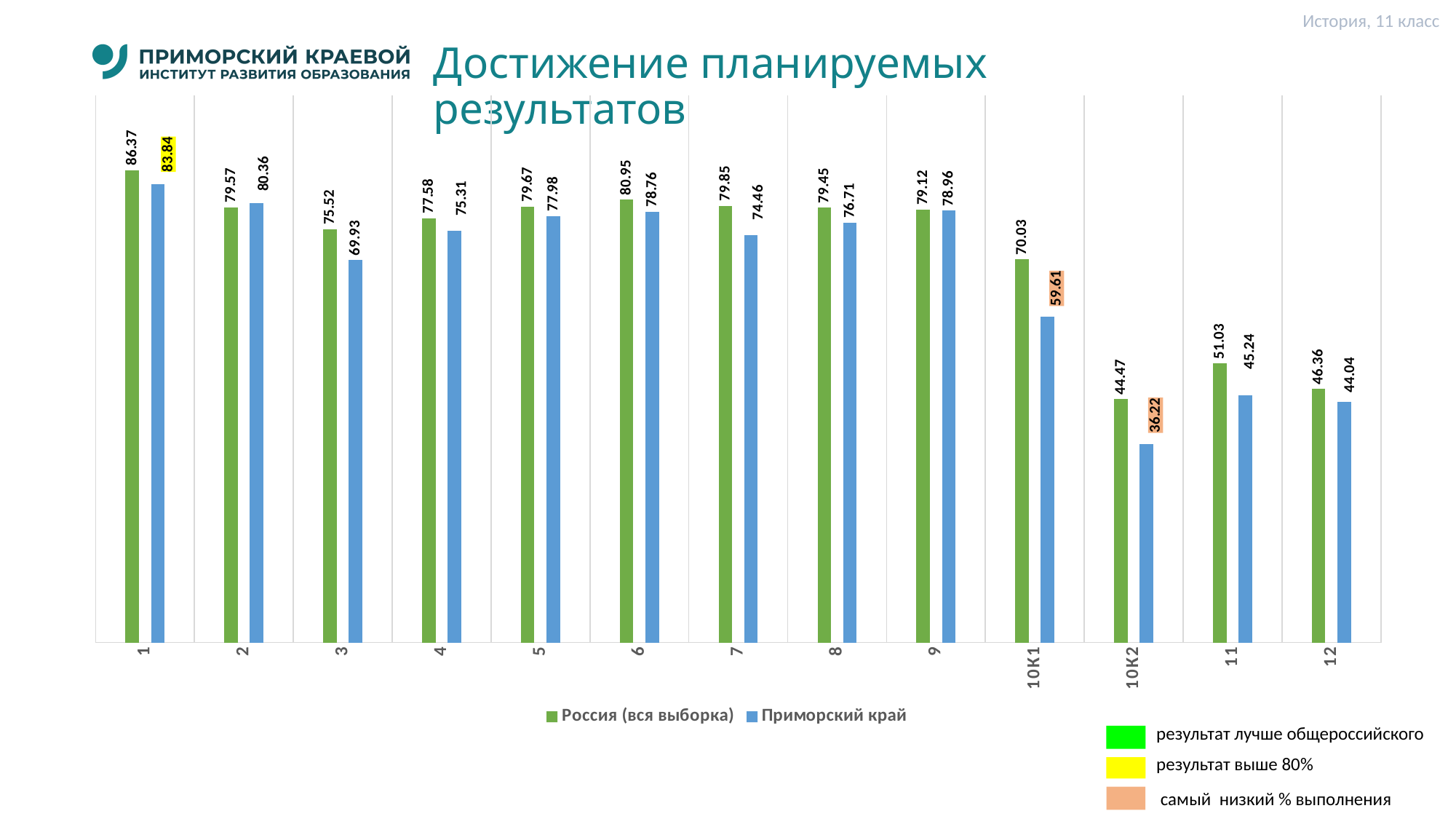
What is the value for Приморский край for category 10К2? 36.22 What is the difference between the Россия (вся выборка) and Приморский край values for category 10К1? 10.42 How many categories are shown on the x axis of the chart? 13 What kind of chart is shown on the slide? Bar chart Which category has the lowest value for Приморский край? 10К2 What is the value for Россия (вся выборка) for category 10К1? 70.03 How many series does the chart legend list? 2 For category 7, which series has the larger value: Россия (вся выборка) or Приморский край? Россия (вся выборка) For category 2, which series has the larger value: Россия (вся выборка) or Приморский край? Приморский край What is the value for Приморский край for category 1? 83.84 What is the difference between the Россия (вся выборка) and Приморский край values for category 3? 5.59 Which category has the highest value for Россия (вся выборка)? 1